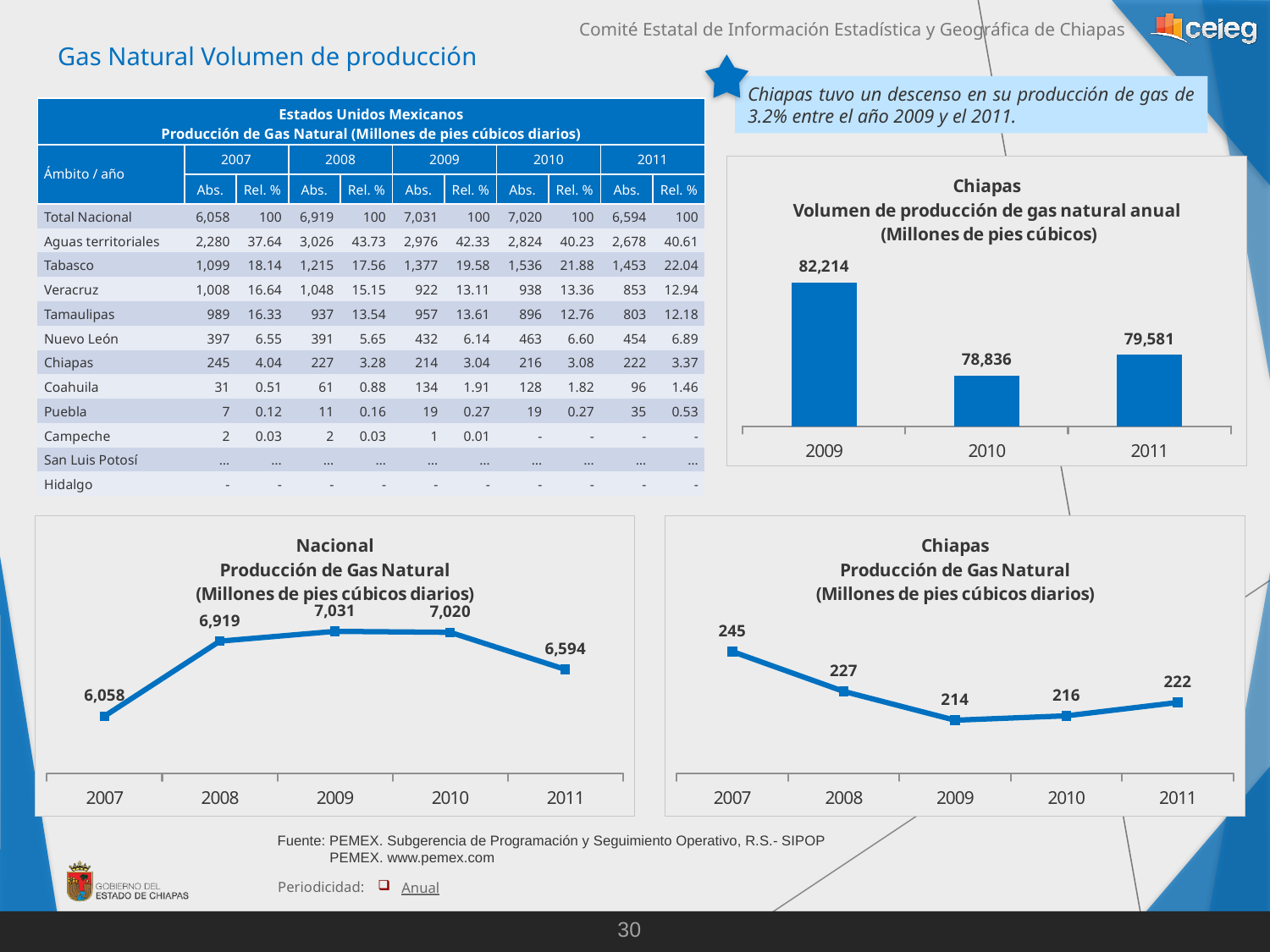
In the 'Nacional Producción de Gas Natural' line chart, how many years are plotted? 5 What kind of chart is the 'Chiapas Producción de Gas Natural' chart at the bottom right of the slide? line chart In the 'Chiapas Producción de Gas Natural' line chart, which is larger, the value for 2008 or the value for 2011? 2008 In the 'Nacional Producción de Gas Natural' line chart, what is the value for 2011? 6,594 In the 'Nacional Producción de Gas Natural' line chart, which year has the highest value? 2009 In the 'Chiapas Volumen de producción de gas natural anual' bar chart, what is the value for 2009? 82,214 In the 'Chiapas Producción de Gas Natural' line chart, what is the value for 2009? 214 In the 'Chiapas Volumen de producción de gas natural anual' bar chart, which year has the lowest value? 2010 In the 'Nacional Producción de Gas Natural' line chart, what is the difference between the 2008 and 2007 values? 861 In the 'Chiapas Producción de Gas Natural' line chart, do the values rise or fall from 2007 to 2009? fall In the 'Chiapas Volumen de producción de gas natural anual' bar chart, what is the difference between the 2009 and 2011 values? 2,633 What kind of chart is the 'Chiapas Volumen de producción de gas natural anual' chart? bar chart